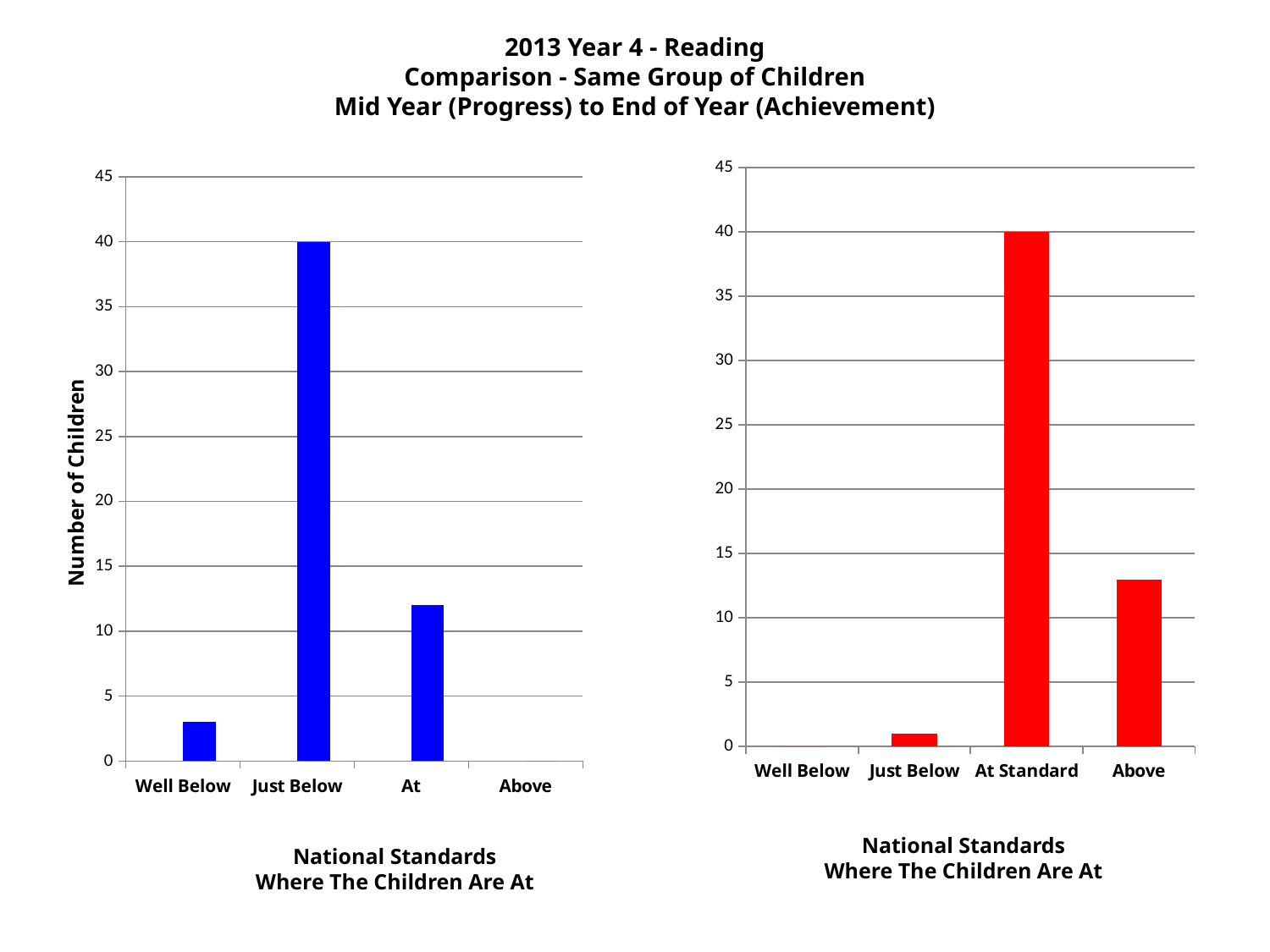
In the right chart, which category has the lowest value? Well Below In the right chart, is the value for Above greater or less than 10? greater In the left chart, is the value for Well Below greater or less than 5? less In the left chart, which category has the lowest value? Above In the right chart, which category has the highest value? At Standard What kind of chart is the right chart? bar chart In the left chart, is the value for At greater or less than 10? greater How many categories are shown on the x axis of the left chart? 4 In the right chart, what is the value for At Standard? 40 In the left chart, what is the value for Just Below? 40 In the left chart, which category has the highest value? Just Below